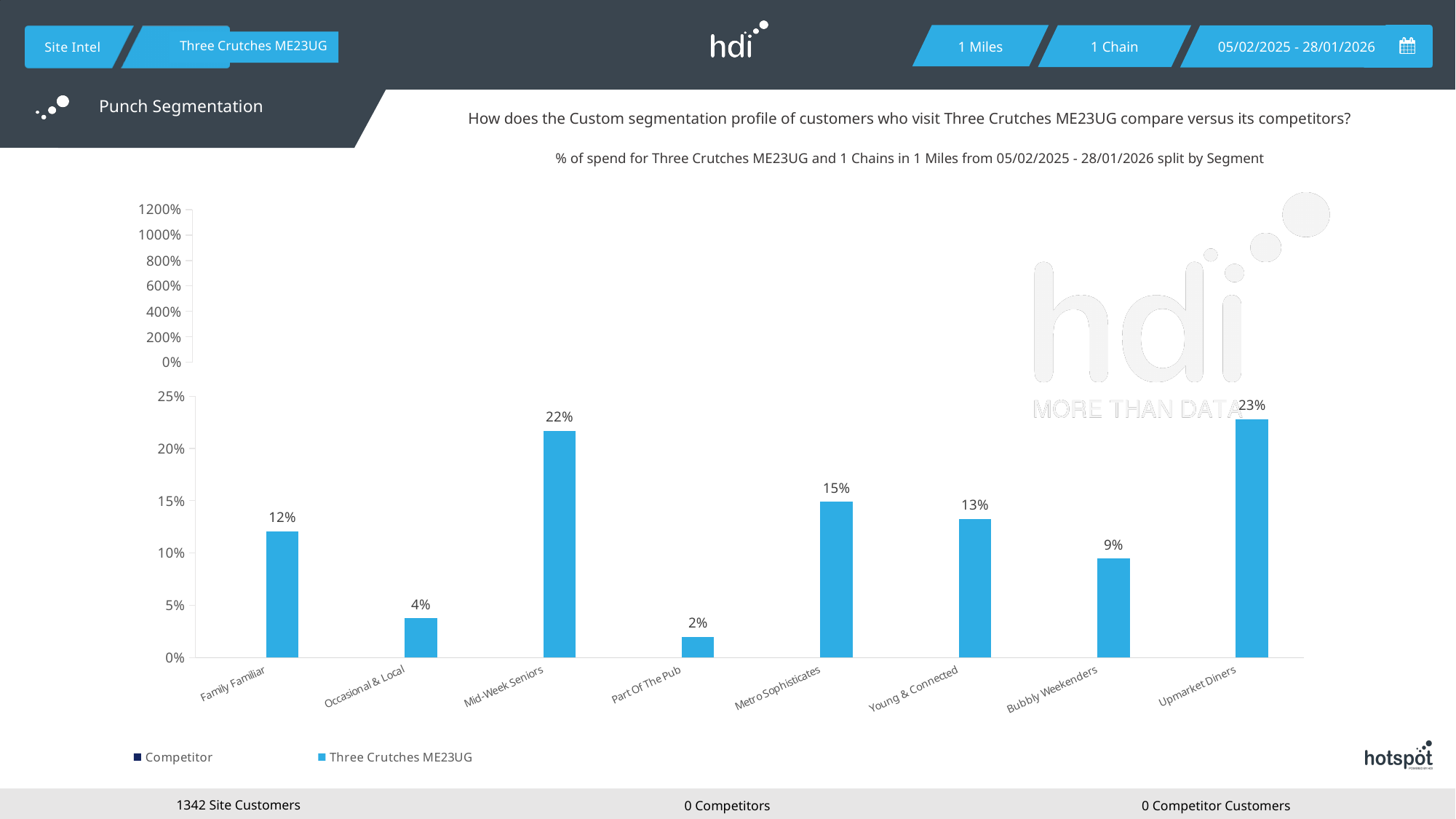
Which segment has the lowest value? Part Of The Pub Which is larger, the value for Metro Sophisticates or the value for Young & Connected? Metro Sophisticates Which segment has the highest value? Upmarket Diners How many segments are shown on the x axis? 8 What is the value for Mid-Week Seniors? 22% What is the value for Family Familiar? 12% What are the two series named in the legend? Competitor and Three Crutches ME23UG How many series does the legend list? 2 What is the difference between the values for Metro Sophisticates and Occasional & Local? 11% What kind of chart is shown? Bar chart What is the value for Bubbly Weekenders? 9% What is the value for Young & Connected? 13%